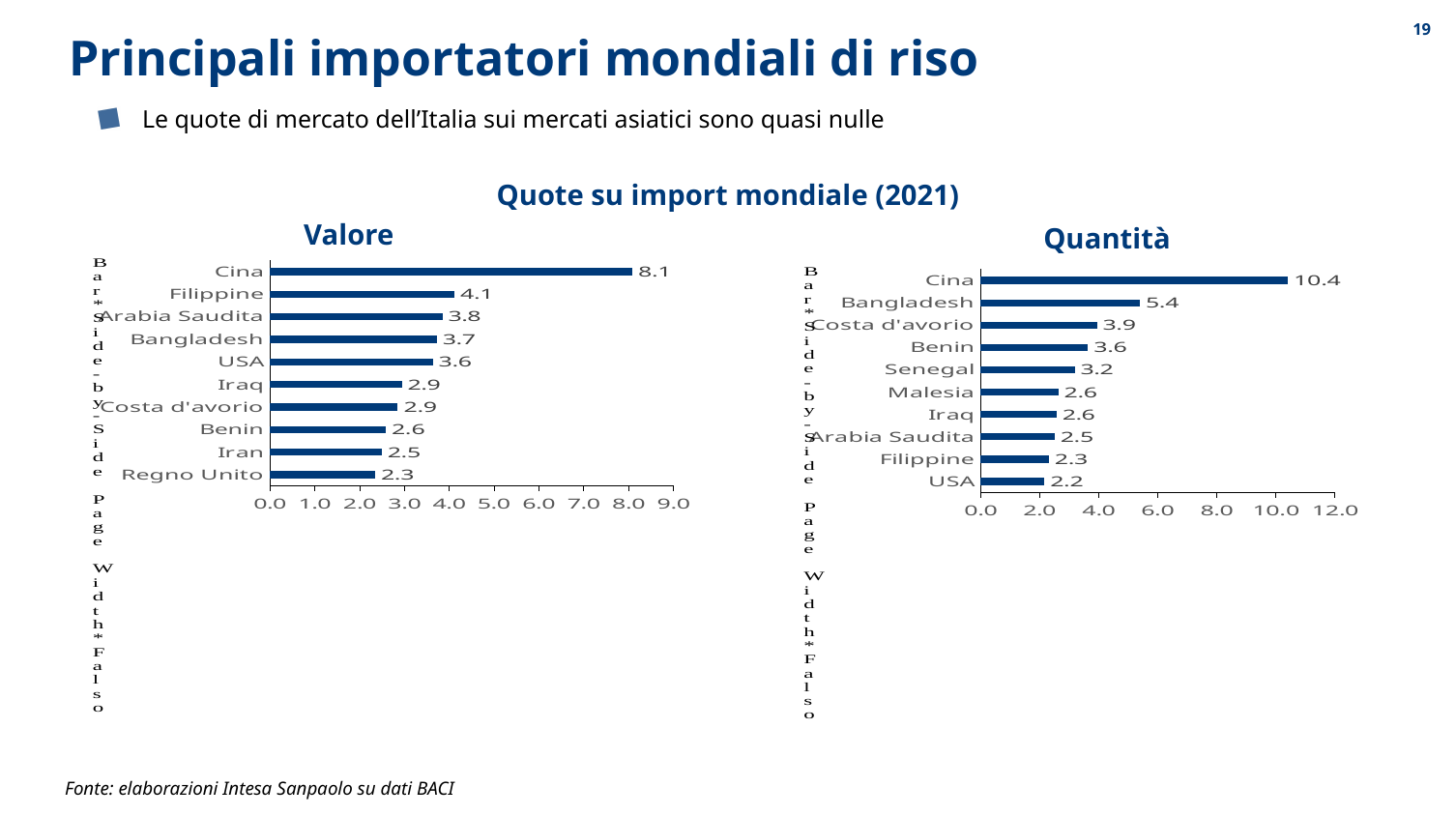
In the Valore chart, what is the value for Regno Unito? 2.3 What kind of chart is the Quantità chart? Bar chart In the Quantità chart, what is the difference between Cina and Bangladesh? 5.0 In the Quantità chart, is the value for Cina greater or less than 10.0? greater In the Quantità chart, which country has the highest value? Cina In the Valore chart, what is the value for Cina? 8.1 In the Valore chart, what is the difference between Cina and Filippine? 4.0 How many countries are shown in the Valore chart? 10 What is the overall title above the two charts? Quote su import mondiale (2021) In the Valore chart, which is larger, the value for Filippine or the value for USA? Filippine In the Quantità chart, what is the value for Bangladesh? 5.4 In the Quantità chart, which country has the lowest value? USA